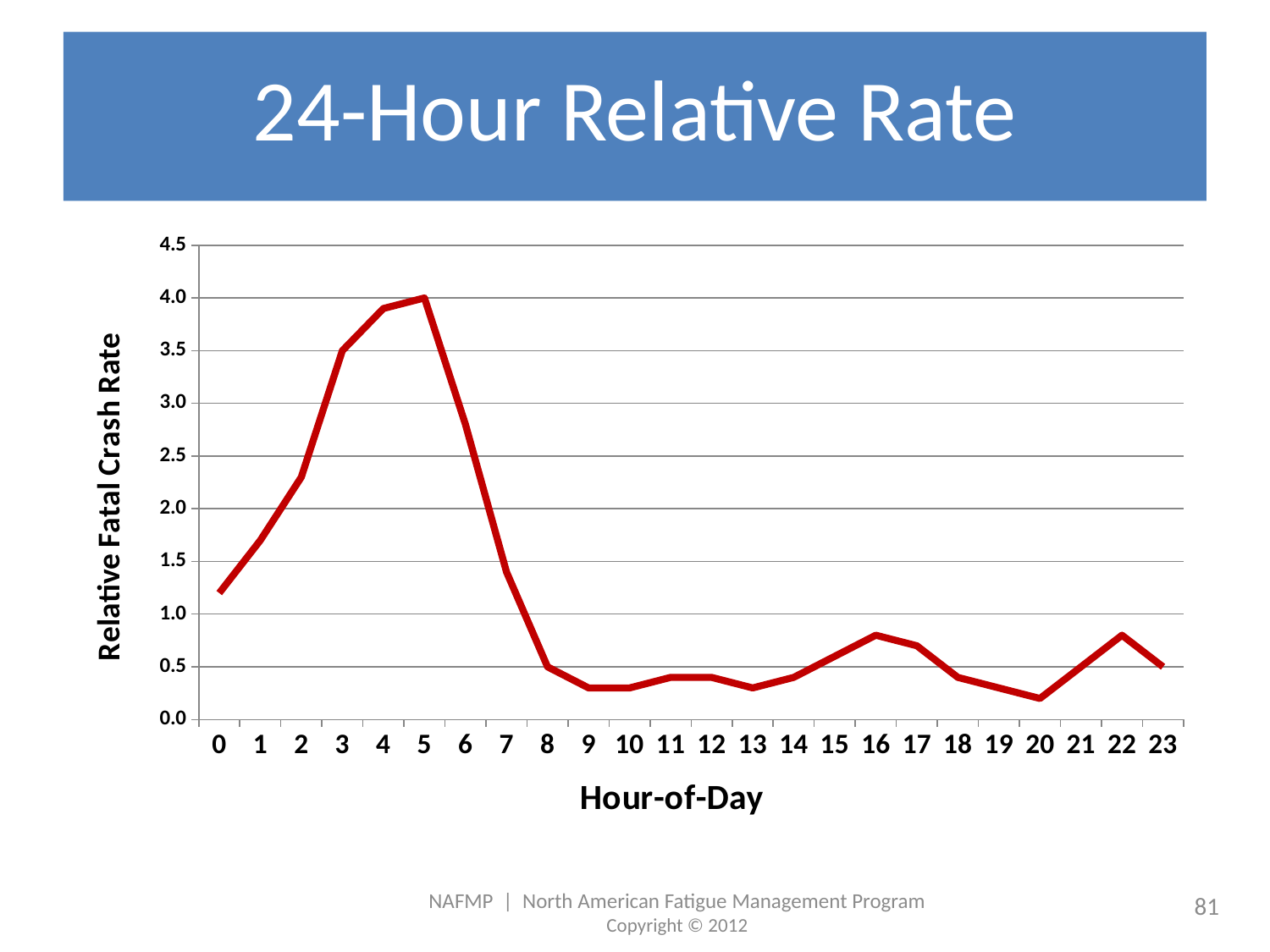
Is the relative fatal crash rate at hour 4 greater or less than 3.5? greater Which hour has a higher relative fatal crash rate, hour 4 or hour 16? hour 4 Is the relative fatal crash rate at hour 6 greater or less than 3.5? less Does the relative fatal crash rate rise or fall between hour 5 and hour 8? fall What is the relative fatal crash rate at hour 5? 4.0 Is the relative fatal crash rate at hour 2 greater or less than 2.0? greater At which hour of day is the relative fatal crash rate lowest? 20 What kind of chart is shown on the slide? line chart How many hour-of-day points are plotted on the chart? 24 What is the relative fatal crash rate at hour 8? 0.5 At which hour of day is the relative fatal crash rate highest? 5